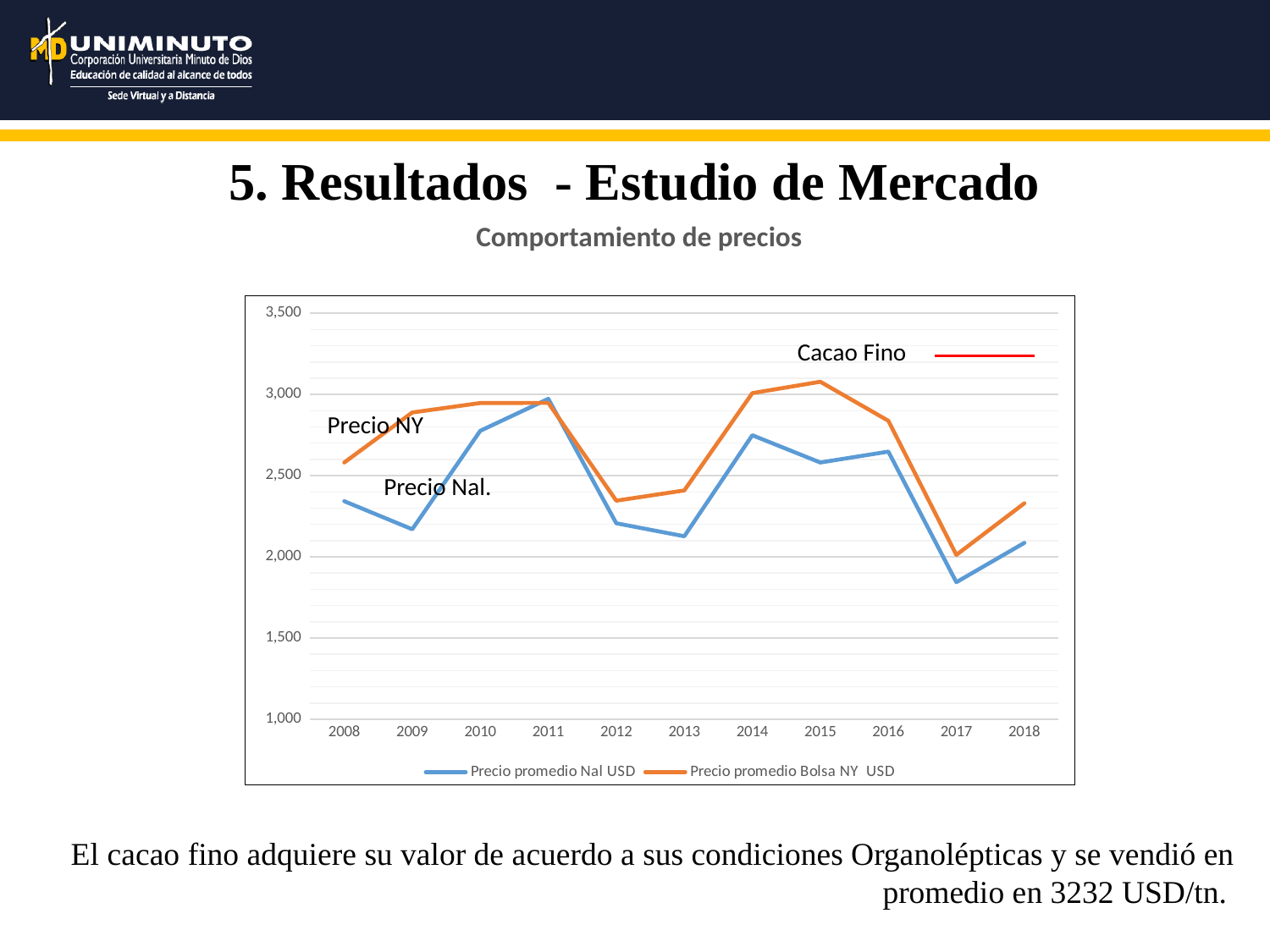
Is the value of Precio promedio Bolsa NY USD in 2012 greater or less than 2,500? less Is the value of Precio promedio Nal USD in 2017 greater or less than 2,000? less In which year is Precio promedio Bolsa NY USD at its lowest? 2017 What is the title shown above the chart? Comportamiento de precios What colour is the line for Precio promedio Nal USD? Blue Does Precio promedio Bolsa NY USD rise or fall from 2015 to 2017? Fall In which year is Precio promedio Nal USD at its highest? 2011 In 2009, which series has the larger value, Precio promedio Nal USD or Precio promedio Bolsa NY USD? Precio promedio Bolsa NY USD Is the value of Precio promedio Bolsa NY USD in 2015 greater or less than 3,000? greater How many series does the chart legend list? 2 How many years are plotted along the x axis of the chart? 11 What kind of chart is shown on the slide? Line chart